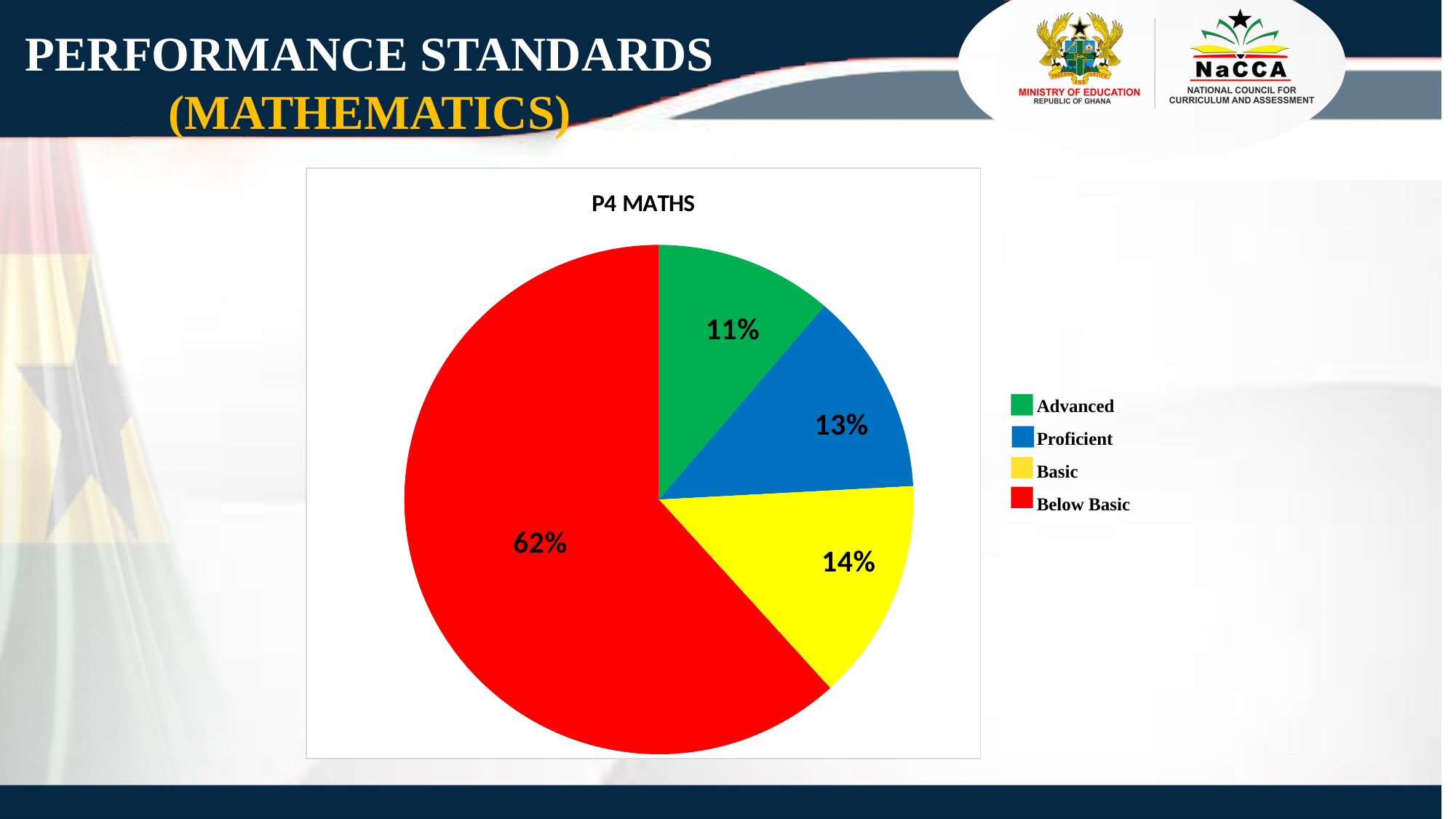
What is the difference between the Below Basic share and the Basic share? 48% What percentage of the pie is labelled Proficient? 13% Which category has the smallest share of the pie? Advanced What percentage of the pie is labelled Below Basic? 62% What colour is the Below Basic slice? red Which is larger, the Proficient share or the Advanced share? Proficient How many categories does the pie chart have? 4 Which category has the largest share of the pie? Below Basic What is the title of the chart? P4 MATHS What percentage of the pie is labelled Basic? 14% What percentage of the pie is labelled Advanced? 11% What type of chart is shown on the slide? pie chart